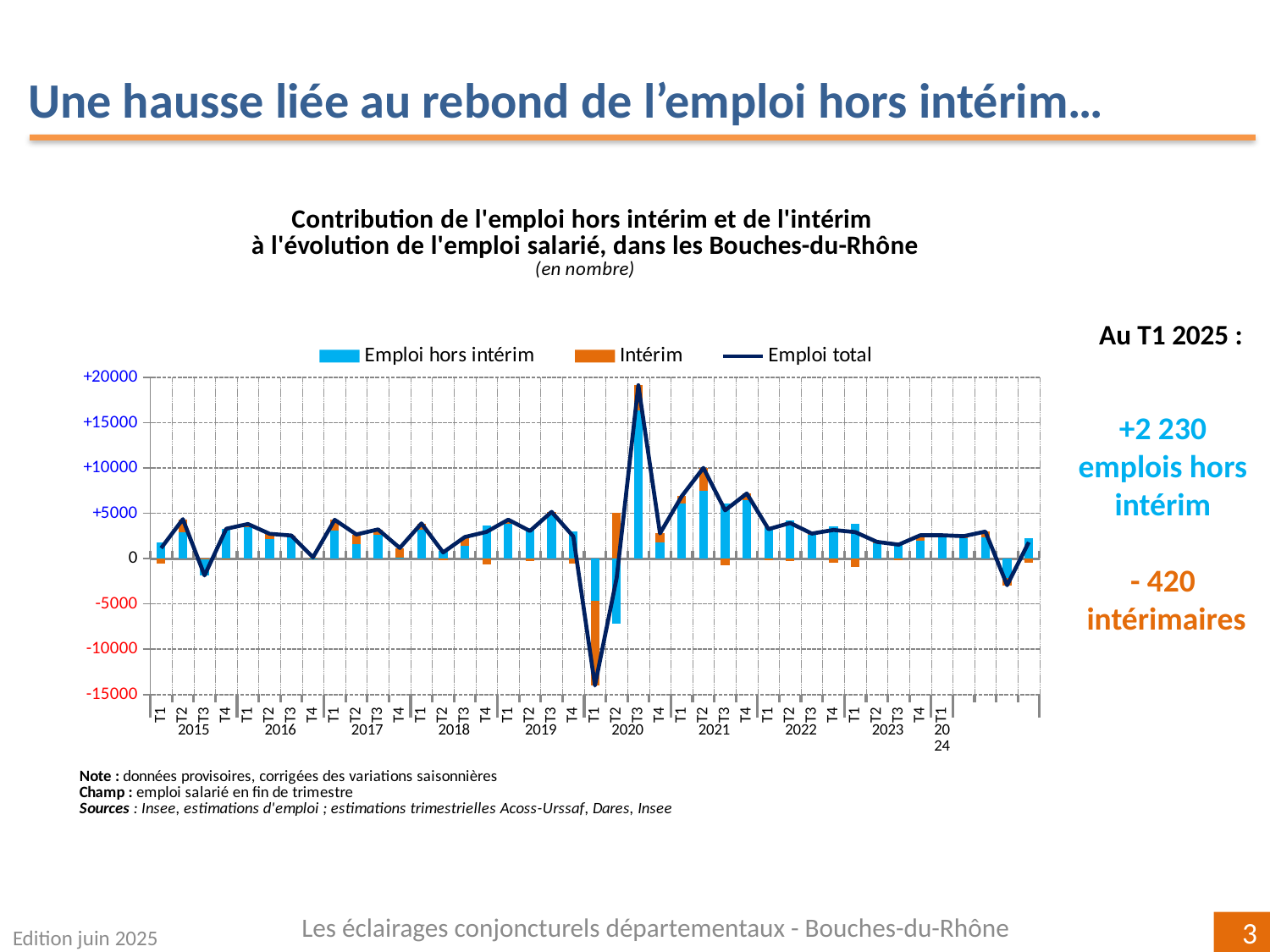
What kind of chart is shown on the slide? A combined bar and line chart Which series are listed in the chart legend? Emploi hors intérim, Intérim, Emploi total What is the value for Intérim at T1 2025, as stated on the slide? - 420 Which colour represents the Intérim series in the chart? Orange Is the value of Emploi total at T1 2020 greater or less than -10000? less How many series does the chart legend list? 3 What is the value for Emploi hors intérim at T1 2025, as stated on the slide? +2 230 Which is larger, the Emploi total value at T3 2020 or at T2 2021? T3 2020 In which quarter does the Emploi total line reach its highest value? T3 2020 In which quarter does the Emploi total line reach its lowest value? T1 2020 Is the value of Emploi hors intérim at T2 2020 greater or less than -5000? less Is the value of Emploi total at T3 2020 greater or less than +15000? greater